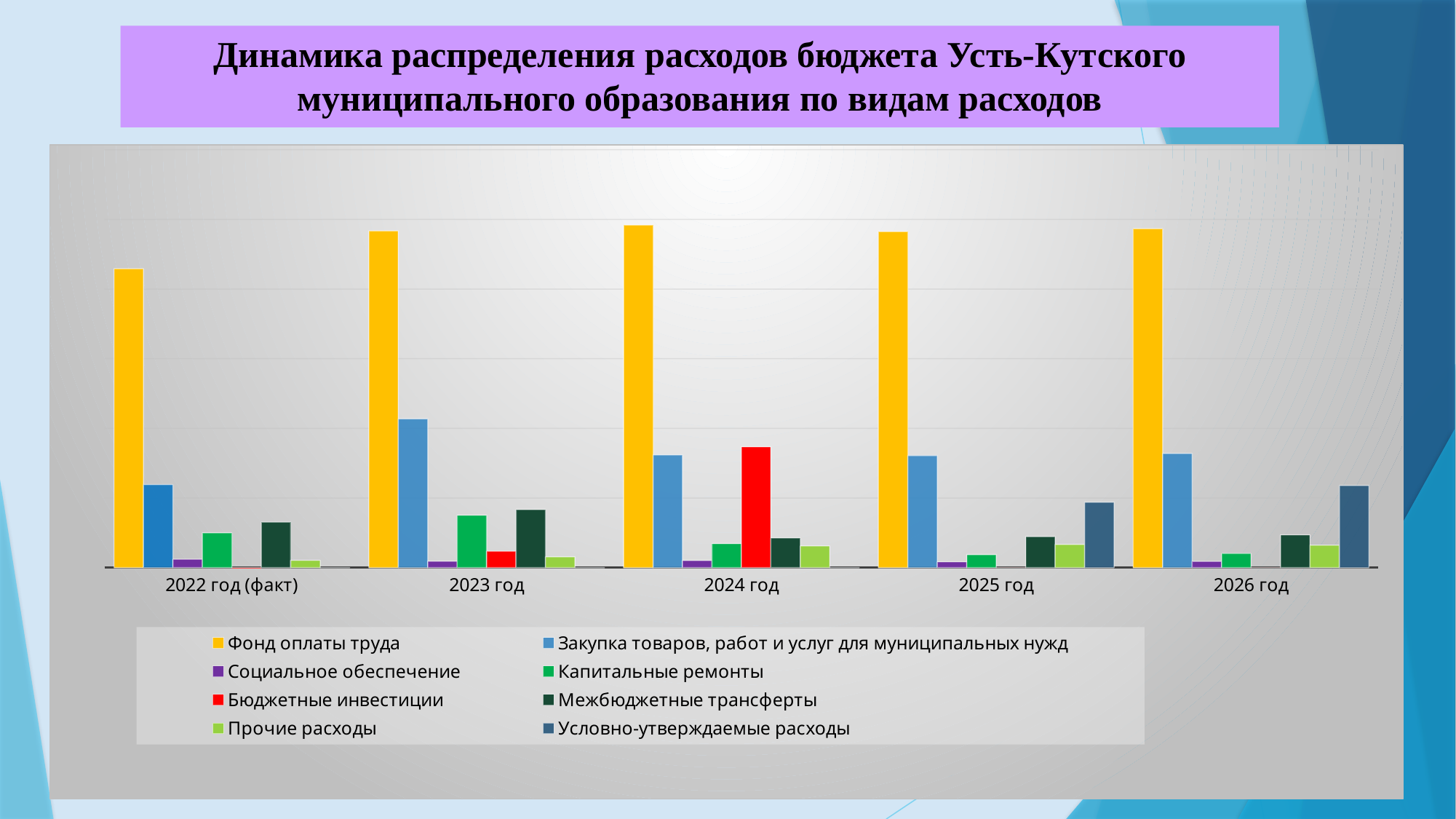
In which year is the bar for Бюджетные инвестиции the highest? 2024 год In which year is the bar for Фонд оплаты труда the lowest? 2022 год (факт) In 2023 год, which is larger: Закупка товаров, работ и услуг для муниципальных нужд or Капитальные ремонты? Закупка товаров, работ и услуг для муниципальных нужд Which series has the tallest bar in every year? Фонд оплаты труда What colour represents Фонд оплаты труда in the legend? Yellow How many year categories are shown on the x axis? 5 In 2026 год, which is larger: Закупка товаров, работ и услуг для муниципальных нужд or Условно-утверждаемые расходы? Закупка товаров, работ и услуг для муниципальных нужд Which year has the higher bar for Условно-утверждаемые расходы, 2025 год or 2026 год? 2026 год What kind of chart is shown on the slide? Bar chart How many series does the legend list? 8 In which year is the bar for Закупка товаров, работ и услуг для муниципальных нужд the highest? 2023 год Does the bar for Фонд оплаты труда rise or fall from 2022 год (факт) to 2023 год? Rise